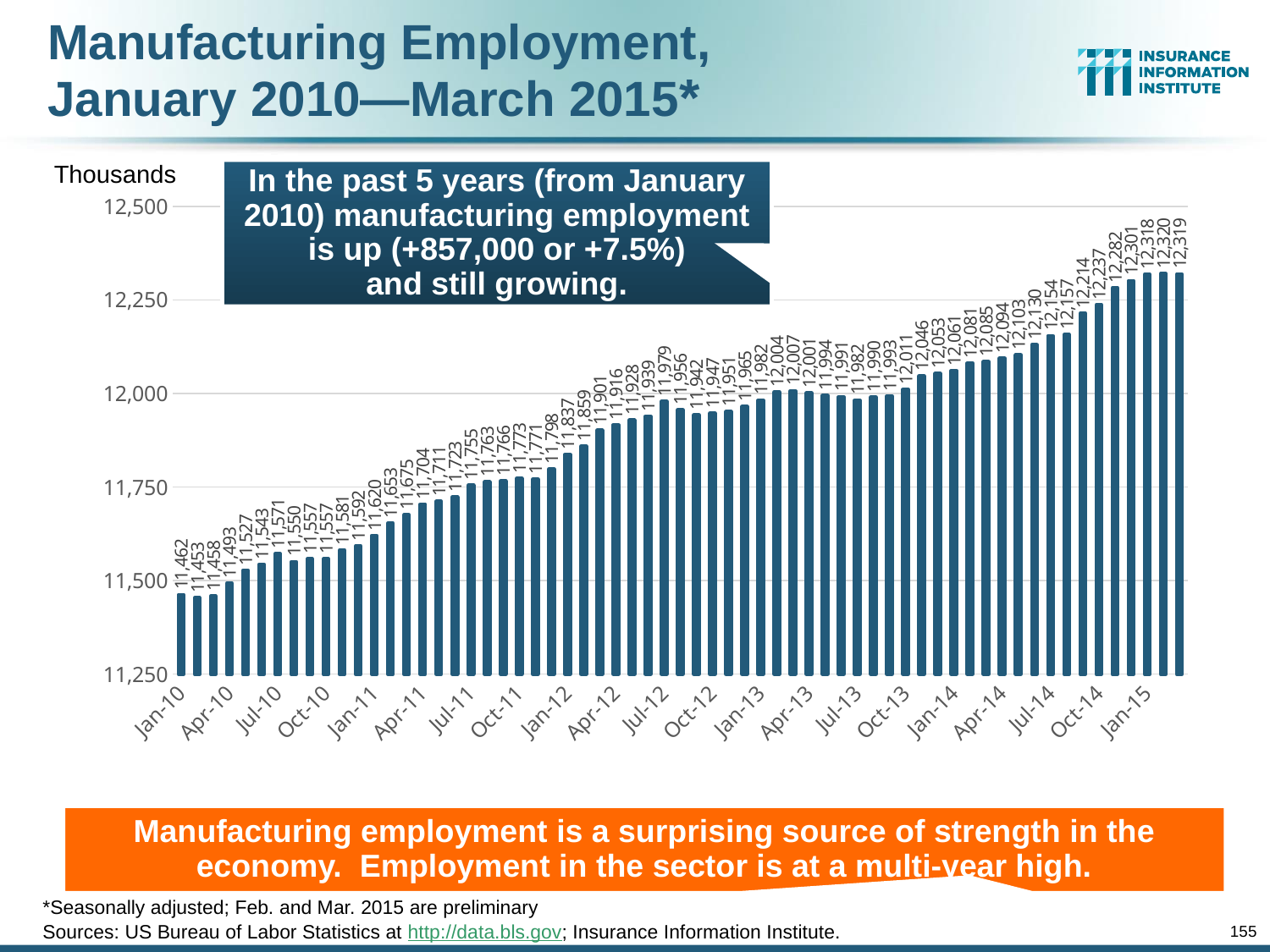
What is the highest value labeled on the chart? 12,320 What is the lowest value labeled on the chart? 11,453 What is the value shown for Jul-12? 11,979 What unit is indicated for the vertical axis? Thousands What kind of chart is shown on the slide? Bar chart What is the manufacturing employment value (in thousands) for Jan-15? 12,318 Do the values generally rise or fall from Jan-10 to Jan-15? Rise Which is larger, the value for Jan-10 or the value for Jan-11? Jan-11 Is the value for Jan-12 greater or less than 11,750? greater What is the manufacturing employment value (in thousands) for Jan-10? 11,462 What is the value shown for Oct-14? 12,237 By how much did manufacturing employment (in thousands) increase from Jan-10 to Jan-15? 856